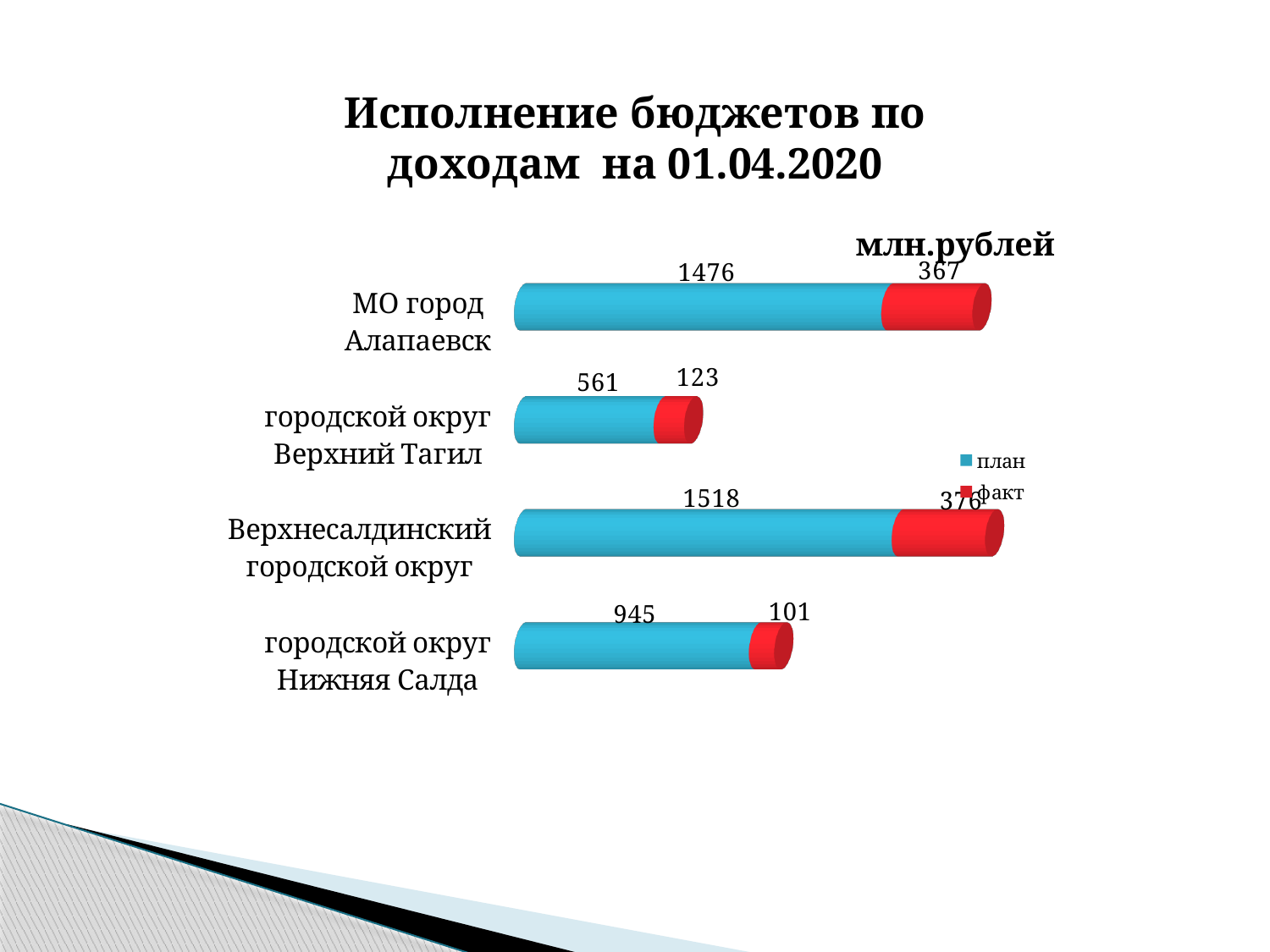
Which is larger, the план value for городской округ Верхний Тагил or the план value for городской округ Нижняя Салда? городской округ Нижняя Салда Which category has the highest план value? Верхнесалдинский городской округ What is the план value for МО город Алапаевск? 1476 How many series does the legend list? 2 What unit is stated above the chart? млн.рублей What is the факт value for городской округ Нижняя Салда? 101 How many categories are shown in the chart? 4 What is the difference between the план and факт values for МО город Алапаевск? 1109 What kind of chart is shown on the slide? bar chart Which category has the lowest факт value? городской округ Нижняя Салда What is the факт value for городской округ Верхний Тагил? 123 What is the план value for Верхнесалдинский городской округ? 1518